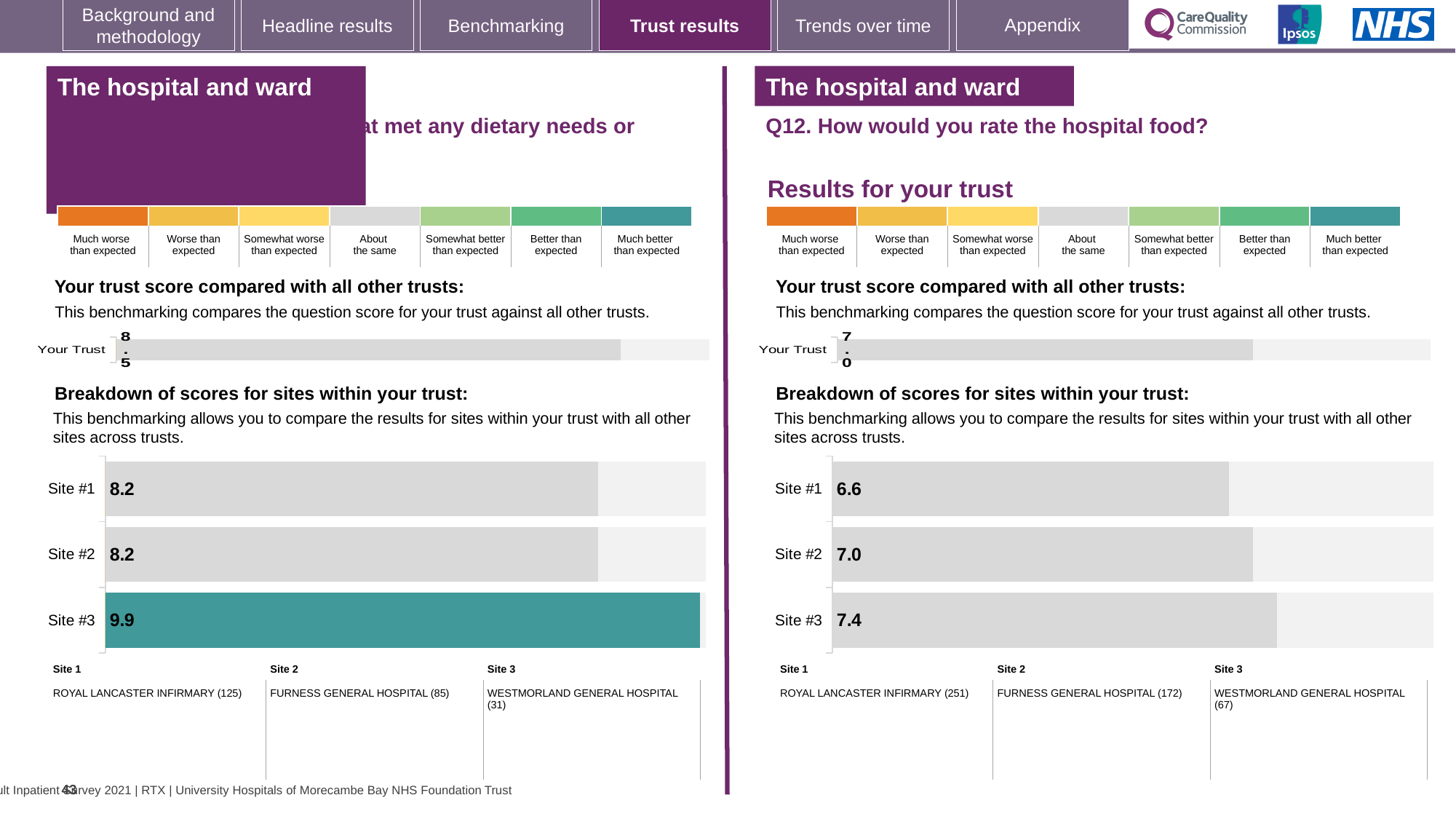
On the right-hand chart (Q12. How would you rate the hospital food?), what is the difference between the scores for Site #3 and Site #1? 0.8 On the right-hand chart (Q12. How would you rate the hospital food?), which site has the lowest score? Site #1 On the left-hand site breakdown chart, what is the score for Site #3? 9.9 On the left-hand site breakdown chart, how many sites are shown? 3 On the left-hand site breakdown chart, which site has the highest score? Site #3 On the right-hand chart (Q12. How would you rate the hospital food?), what is the score for Site #1? 6.6 On the left-hand site breakdown chart, what is the score for Site #1? 8.2 On the right-hand chart (Q12. How would you rate the hospital food?), which site has the highest score? Site #3 On the right-hand chart (Q12. How would you rate the hospital food?), what is the score for Site #3? 7.4 On the left-hand site breakdown chart, what is the difference between the scores for Site #3 and Site #2? 1.7 What kind of chart is used for the site breakdown on the right-hand side of the slide? Bar chart On the left-hand site breakdown chart, which site's bar is coloured teal rather than grey? Site #3